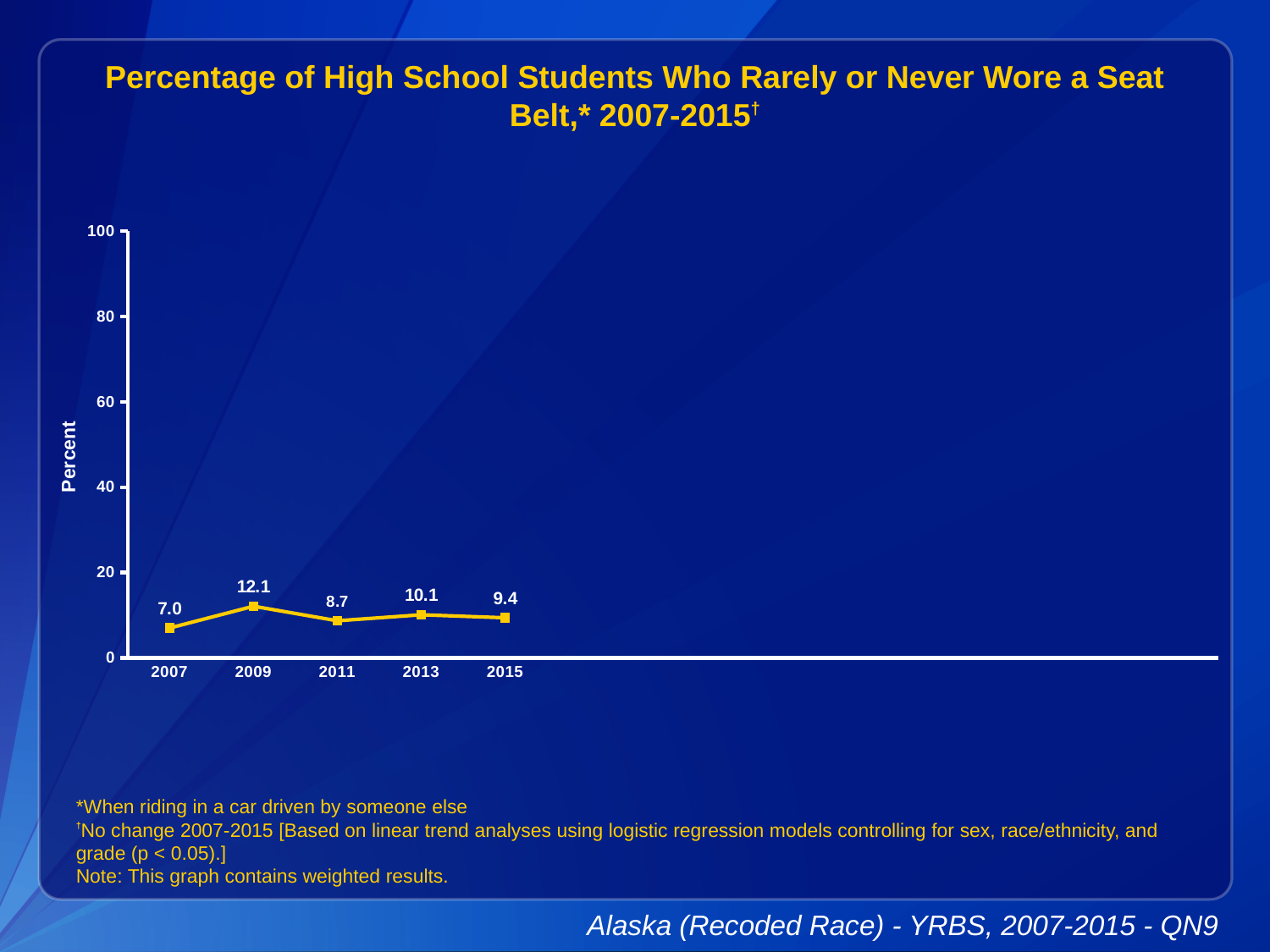
How many years are plotted on the chart? 5 What is the value for 2013? 10.1 What is the value for 2015? 9.4 What is the label of the y axis? Percent What is the value for 2007? 7.0 Is the value for 2009 greater or less than 20? less Which year has the highest value? 2009 What is the value for 2009? 12.1 What kind of chart is shown? line chart Which is larger, the value for 2013 or the value for 2015? 2013 What is the difference between the values for 2009 and 2011? 3.4 Which year has the lowest value? 2007